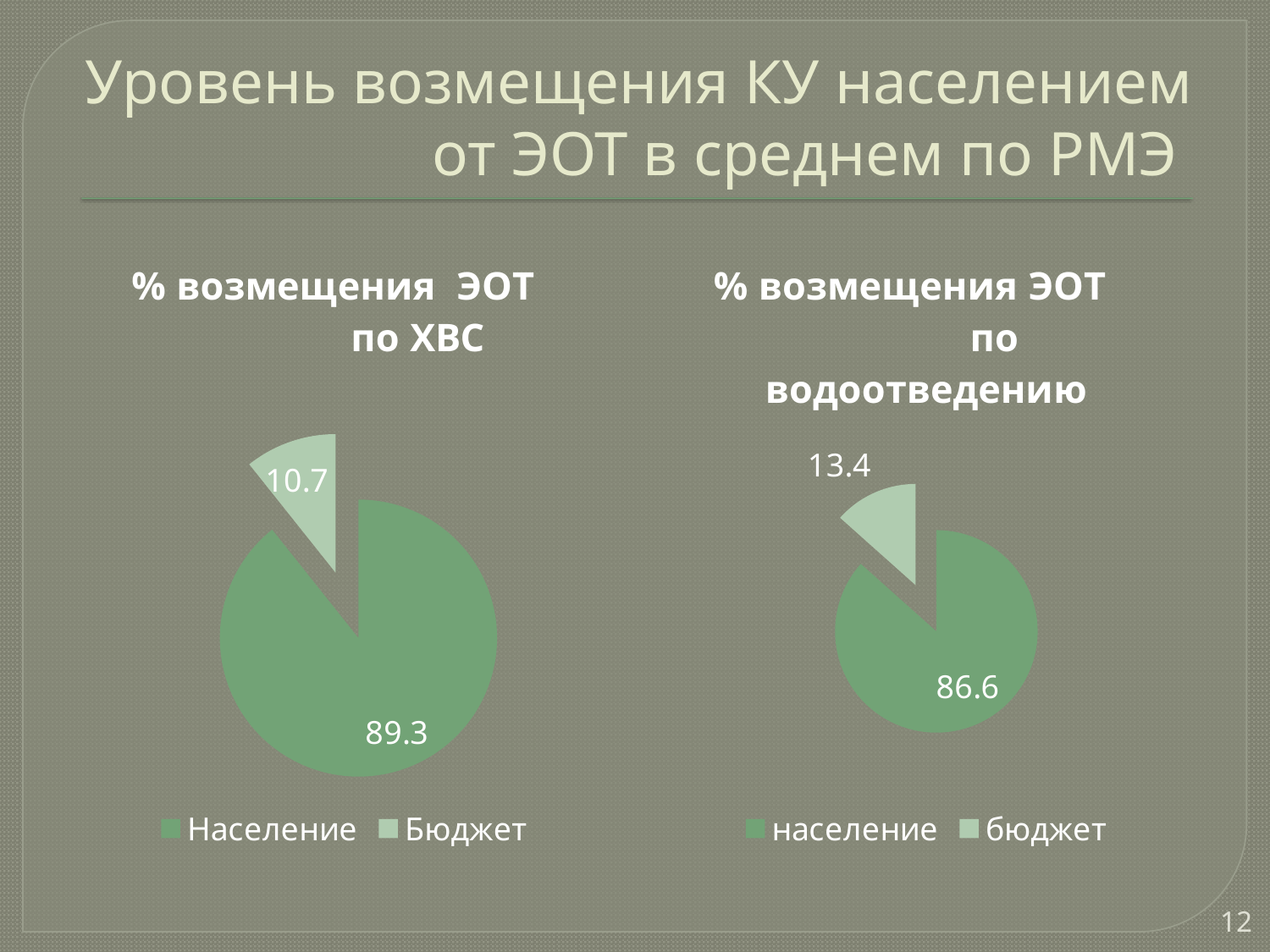
How many entries does the legend of the left chart (% возмещения ЭОТ по ХВС) list? 2 In the left chart (% возмещения ЭОТ по ХВС), what is the value for Население? 89.3 In the right chart (% возмещения ЭОТ по водоотведению), which category has the smallest slice? бюджет In the right chart (% возмещения ЭОТ по водоотведению), what is the difference between the население and бюджет values? 73.2 How many slices does the right chart (% возмещения ЭОТ по водоотведению) have? 2 In the left chart (% возмещения ЭОТ по ХВС), what is the value for Бюджет? 10.7 In the right chart (% возмещения ЭОТ по водоотведению), what is the value for население? 86.6 Which is larger: the Бюджет value in the left chart (по ХВС) or the бюджет value in the right chart (по водоотведению)? бюджет in the right chart (по водоотведению) In the left chart (% возмещения ЭОТ по ХВС), which category has the largest slice? Население In the left chart (% возмещения ЭОТ по ХВС), what is the difference between the Население and Бюджет values? 78.6 In the right chart (% возмещения ЭОТ по водоотведению), what is the value for бюджет? 13.4 What type of chart is the left chart (% возмещения ЭОТ по ХВС)? Pie chart